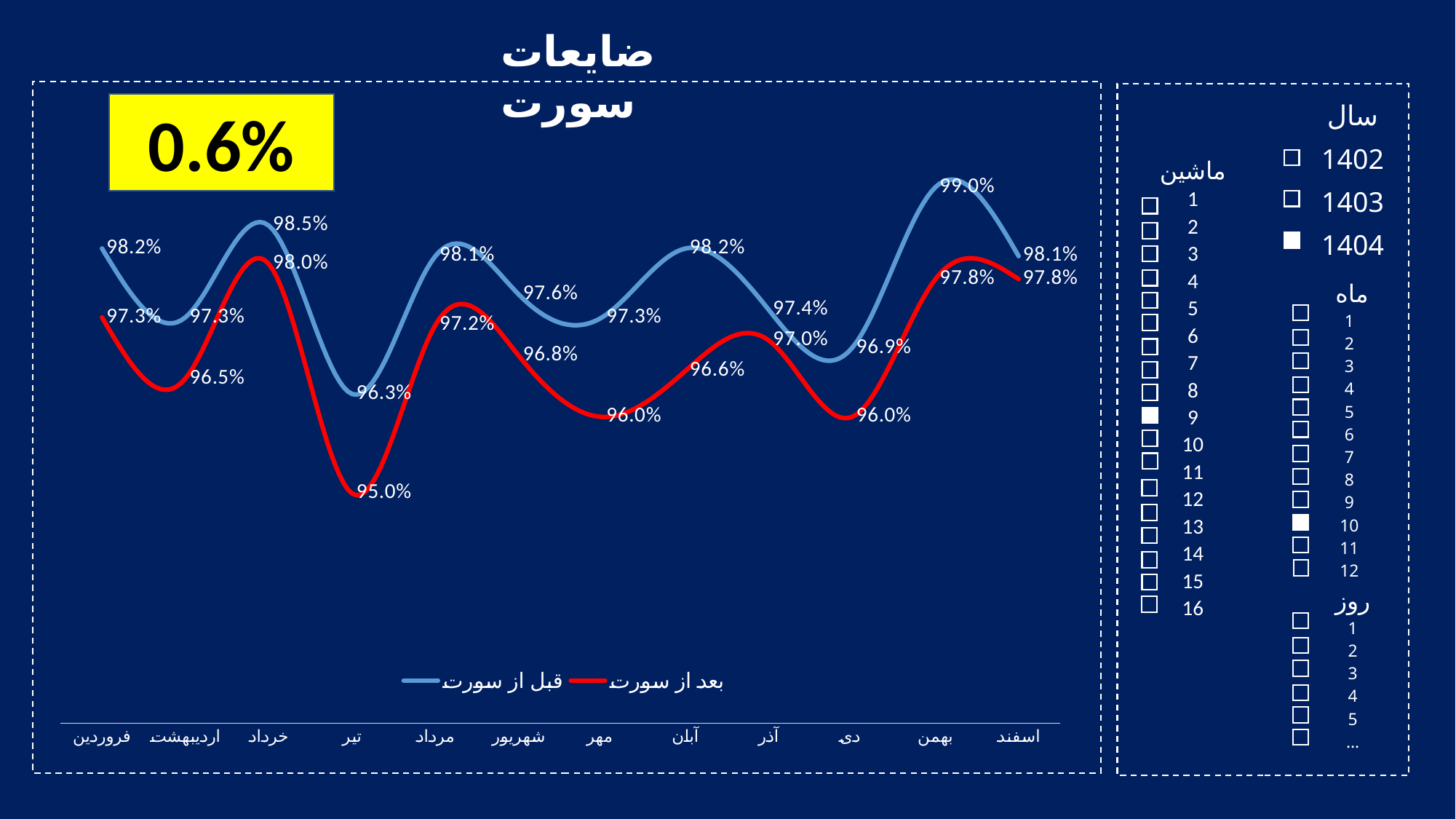
What is the value of the بعد از سورت series for بهمن? 97.8% What type of chart is shown on the slide? line chart What is the value of the قبل از سورت series for فروردین? 98.2% In which month is the قبل از سورت series lowest? تیر What is the title of the chart? ضایعات سورت Does the قبل از سورت series rise or fall from دی to بهمن? rise How many months are shown on the x axis of the chart? 12 How many series does the chart legend list? 2 What is the difference between the بعد از سورت and قبل از سورت values for تیر? 1.3% Which is larger for خرداد: the بعد از سورت value or the قبل از سورت value? قبل از سورت What is the value of the قبل از سورت series for تیر? 96.3%